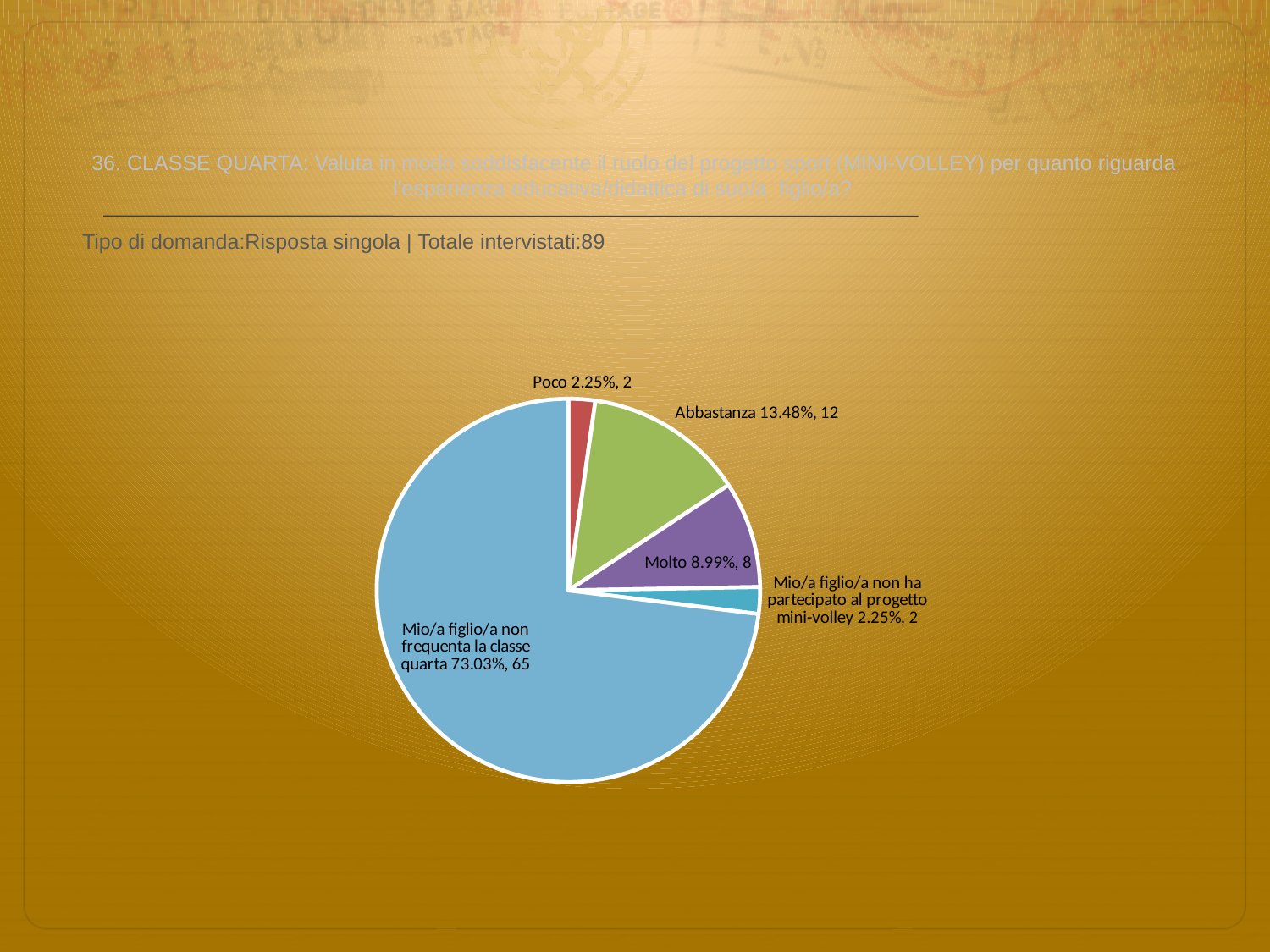
What kind of chart is shown on the slide? pie chart What percentage is shown for the "Abbastanza" slice? 13.48% How many slices does the pie chart have? 5 Which slice is the largest in the pie chart? Mio/a figlio/a non frequenta la classe quarta What share of the pie does the "Mio/a figlio/a non ha partecipato al progetto mini-volley" slice represent? 2.25% What is the difference in count between the "Abbastanza" slice and the "Molto" slice? 4 Which slice is larger, "Molto" or "Abbastanza"? Abbastanza What colour is the largest slice of the pie chart? light blue What is the total number of respondents stated on the slide? 89 What percentage is shown for "Mio/a figlio/a non frequenta la classe quarta"? 73.03% How many respondents are shown for the "Molto" slice? 8 What count is shown for the "Poco" slice? 2